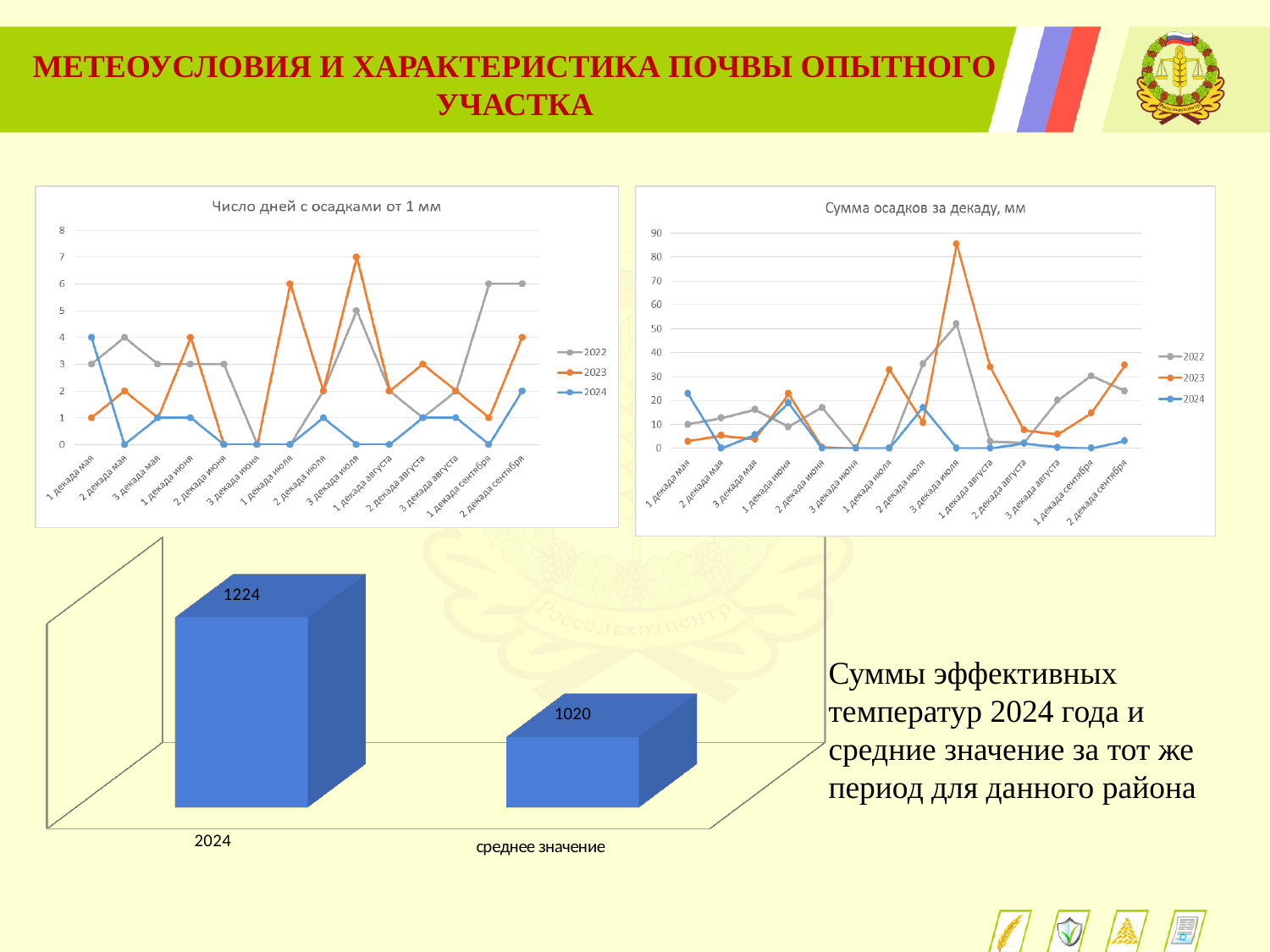
In the chart titled 'Сумма осадков за декаду, мм', is the value for 2023 in 3 декада июля greater or less than 80? greater In the bottom-left bar chart, which is larger: 2024 or среднее значение? 2024 In the chart titled 'Число дней с осадками от 1 мм', what is the value for 2024 in 1 декада мая? 4 In the chart titled 'Число дней с осадками от 1 мм', how many series does the legend list? 3 In the chart titled 'Сумма осадков за декаду, мм', which series has the highest value in 3 декада июля? 2023 In the chart titled 'Сумма осадков за декаду, мм', is the value for 2024 in 1 декада мая greater or less than 20? greater What kind of chart is the one at the bottom left of the slide showing 2024 and среднее значение? bar chart In the chart titled 'Число дней с осадками от 1 мм', what is the value for 2023 in 1 декада августа? 2 In the chart titled 'Число дней с осадками от 1 мм', how many decade categories are shown on the x axis? 14 In the bottom-left bar chart, what is the value for 2024? 1224 In the bottom-left bar chart, what is the difference between the 2024 value and the среднее значение? 204